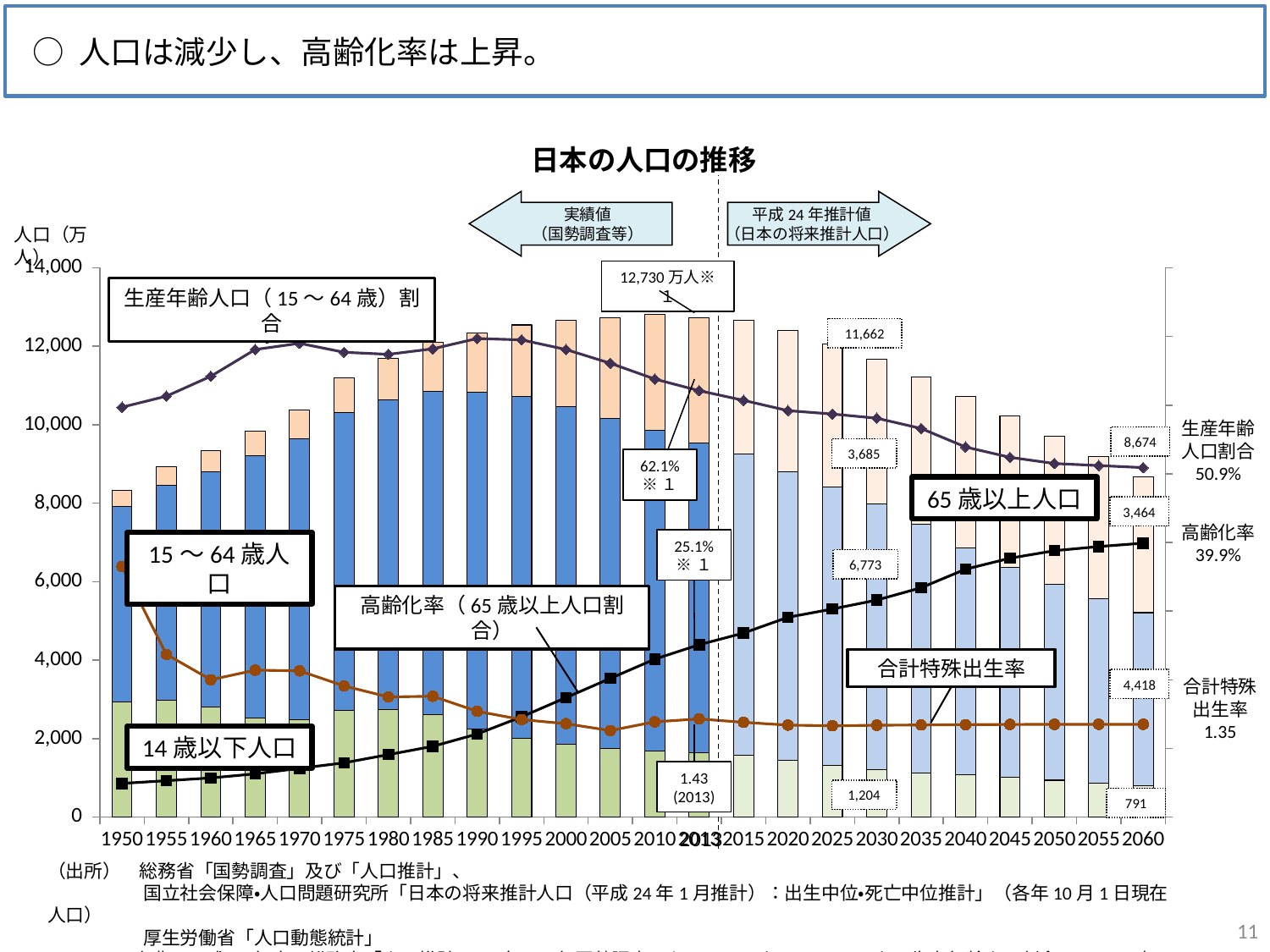
What kind of chart is shown on the slide? A stacked bar chart with line series What is the 合計特殊出生率 shown for 2013? 1.43 What is the 14歳以下人口 value shown for 2060? 791 Does the 高齢化率 line rise or fall from 1950 to 2060? Rises Is the total population for 1950 greater or less than 10,000? less What is the 15～64歳人口 value shown for 2030? 6,773 What is the 高齢化率 shown for 2013? 25.1% What is the total population shown for 2013? 12,730万人 What is the total of the stacked bar for 2030? 11,662 What is the 65歳以上人口 value shown for 2060? 3,464 By how much does the 65歳以上人口 value for 2030 exceed the value for 2060? 221 What is the 生産年齢人口割合 shown for 2060? 50.9%